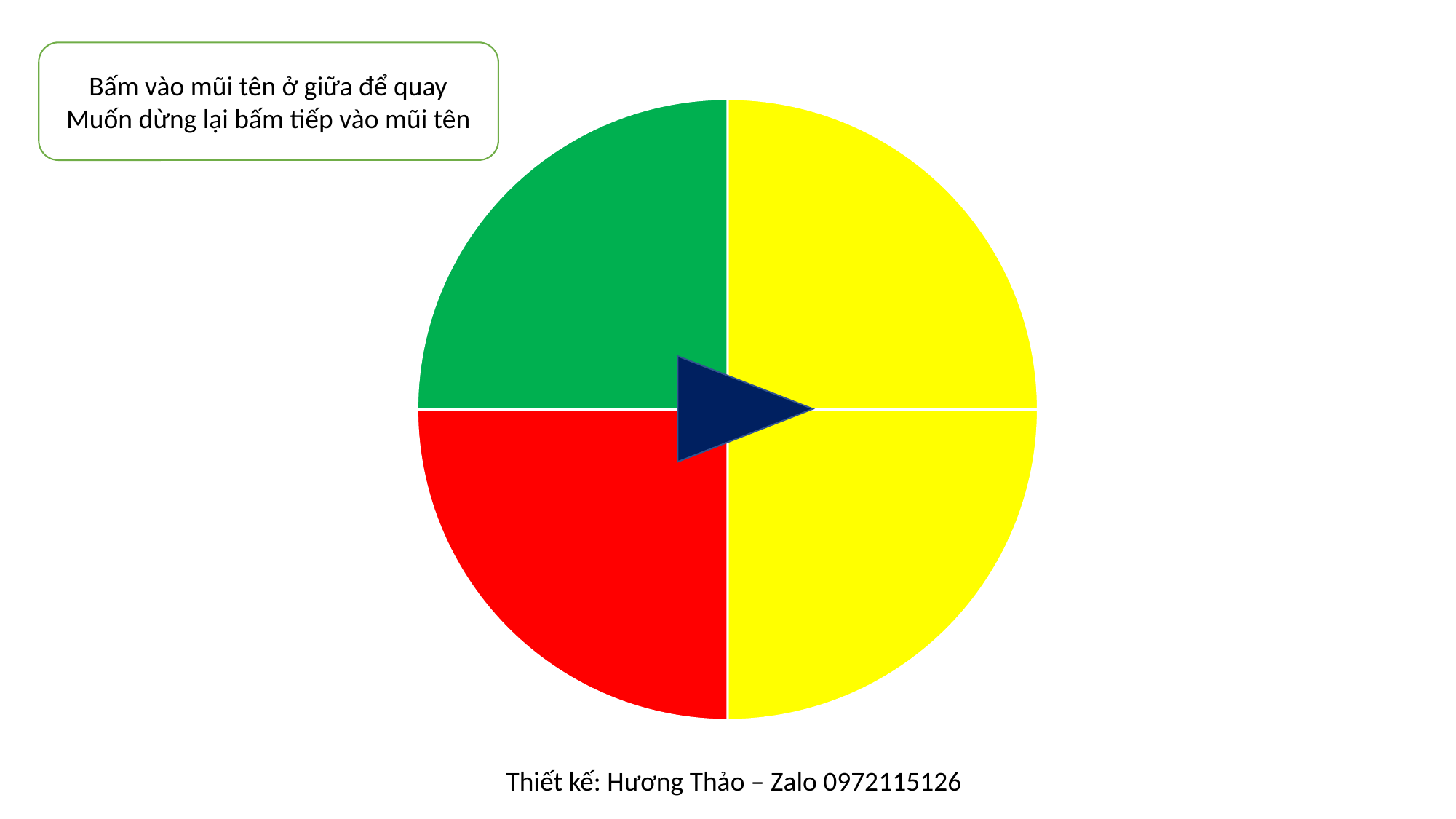
What colour is the top-left quarter of the pie chart? green Which colour covers the largest area of the pie chart? yellow What kind of chart is used for the spinner wheel on the slide? pie chart What colour is the bottom-left quarter of the pie chart? red